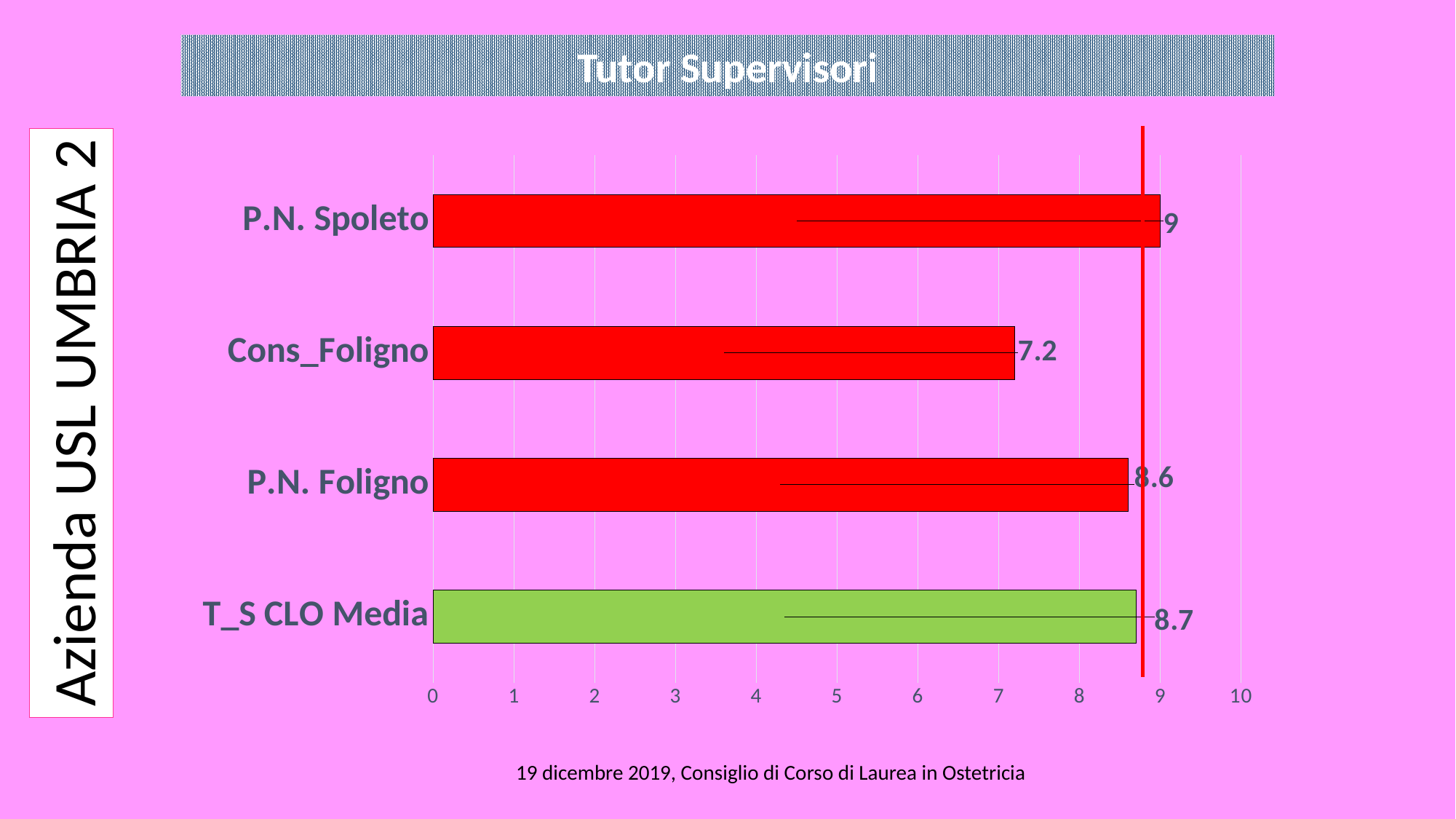
What is the value for T_S CLO Media? 8.7 What is the difference between the values for T_S CLO Media and P.N. Foligno? 0.1 What is the value for P.N. Foligno? 8.6 Which is larger, the value for P.N. Spoleto or the value for Cons_Foligno? P.N. Spoleto What is the difference between the values for P.N. Spoleto and Cons_Foligno? 1.8 What is the title of the chart? Tutor Supervisori How many categories are shown in the chart? 4 What kind of chart is shown on the slide? Bar chart Which category has the lowest value? Cons_Foligno What is the value for P.N. Spoleto? 9 Which category has the highest value? P.N. Spoleto What is the value for Cons_Foligno? 7.2